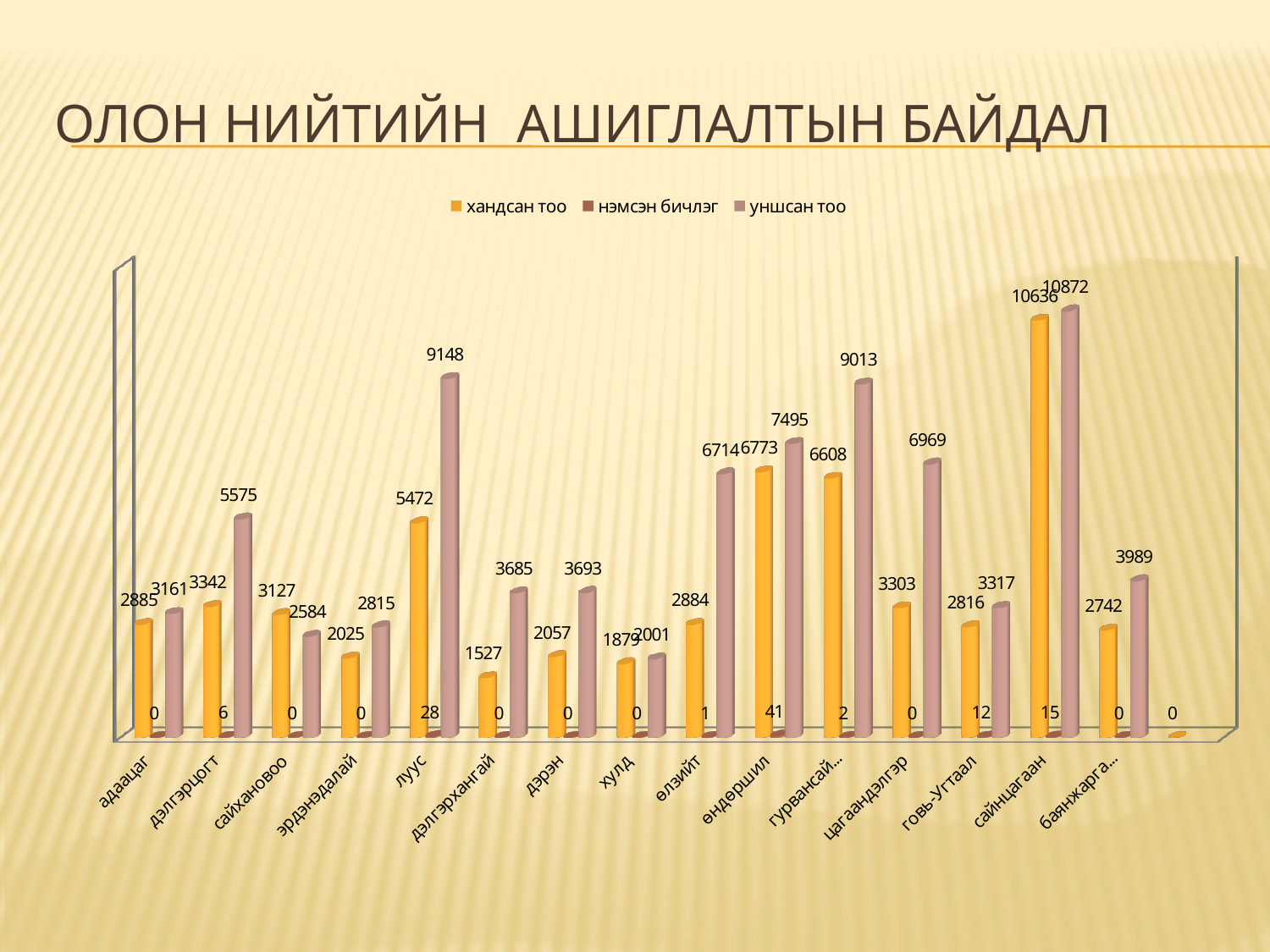
What is the уншсан тоо value for сайнцагаан? 10872 Which category has the highest нэмсэн бичлэг value? өндөршил How many series does the legend list? 3 What kind of chart is shown on the slide? bar chart What is the хандсан тоо value for луус? 5472 Which category has the highest уншсан тоо value? сайнцагаан What is the difference between the уншсан тоо and хандсан тоо values for сайнцагаан? 236 What is the difference between the уншсан тоо and хандсан тоо values for луус? 3676 What is the уншсан тоо value for цагаандэлгэр? 6969 What colour are the хандсан тоо bars? orange For сайхановоо, which is larger: хандсан тоо or уншсан тоо? хандсан тоо What is the нэмсэн бичлэг value for өндөршил? 41